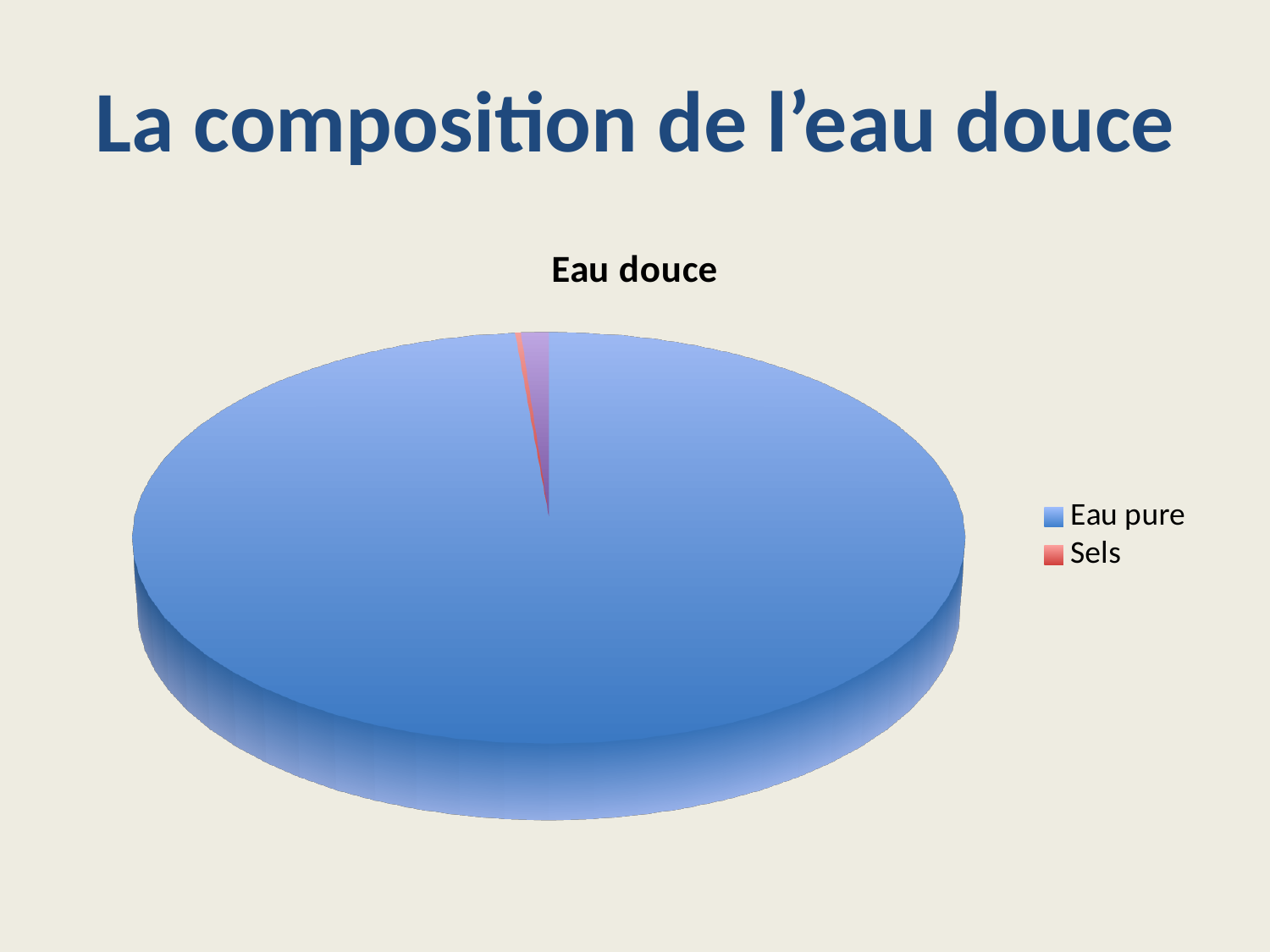
Which category has the smallest slice of the pie? Sels Which category has the largest slice of the pie? Eau pure What is the title of the chart? Eau douce How many categories does the legend list? 2 Which slice is larger, Eau pure or Sels? Eau pure Which category is shown in blue? Eau pure What colour is the Sels slice in the legend? red What kind of chart is shown on the slide? pie chart